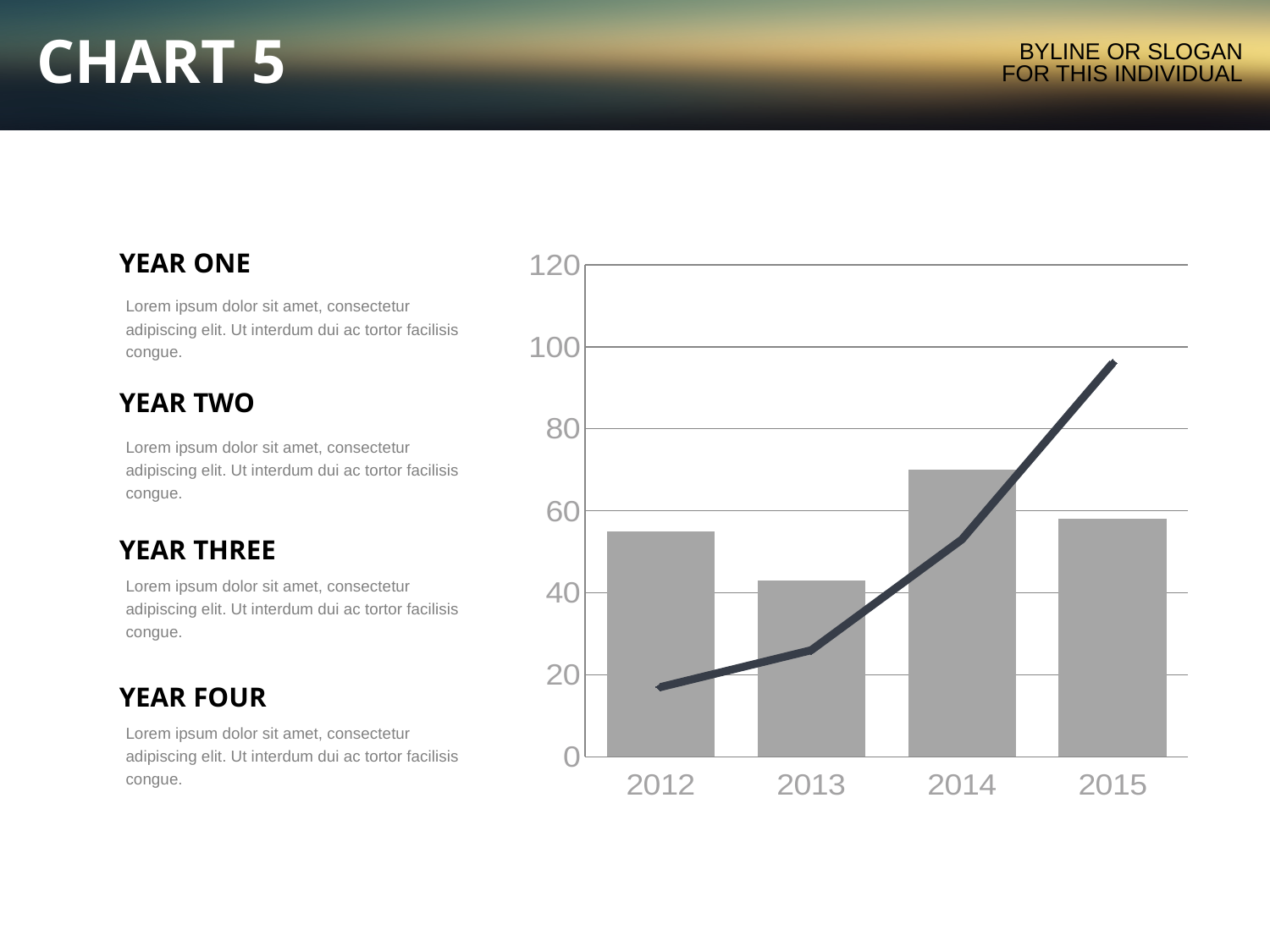
How many years are shown on the x axis of the chart? 4 Which year has the shortest bar? 2013 In which year does the line reach its highest point? 2015 Which year has the tallest bar? 2014 What kind of chart is shown on the slide? A bar chart with a line overlaid Is the bar value for 2013 greater or less than 60? less Is the bar value for 2012 greater or less than 40? greater Is the bar for 2012 taller or shorter than the bar for 2013? taller Is the bar value for 2014 greater or less than 60? greater Is the bar for 2015 taller or shorter than the bar for 2014? shorter Does the line rise or fall from 2012 to 2015? rises